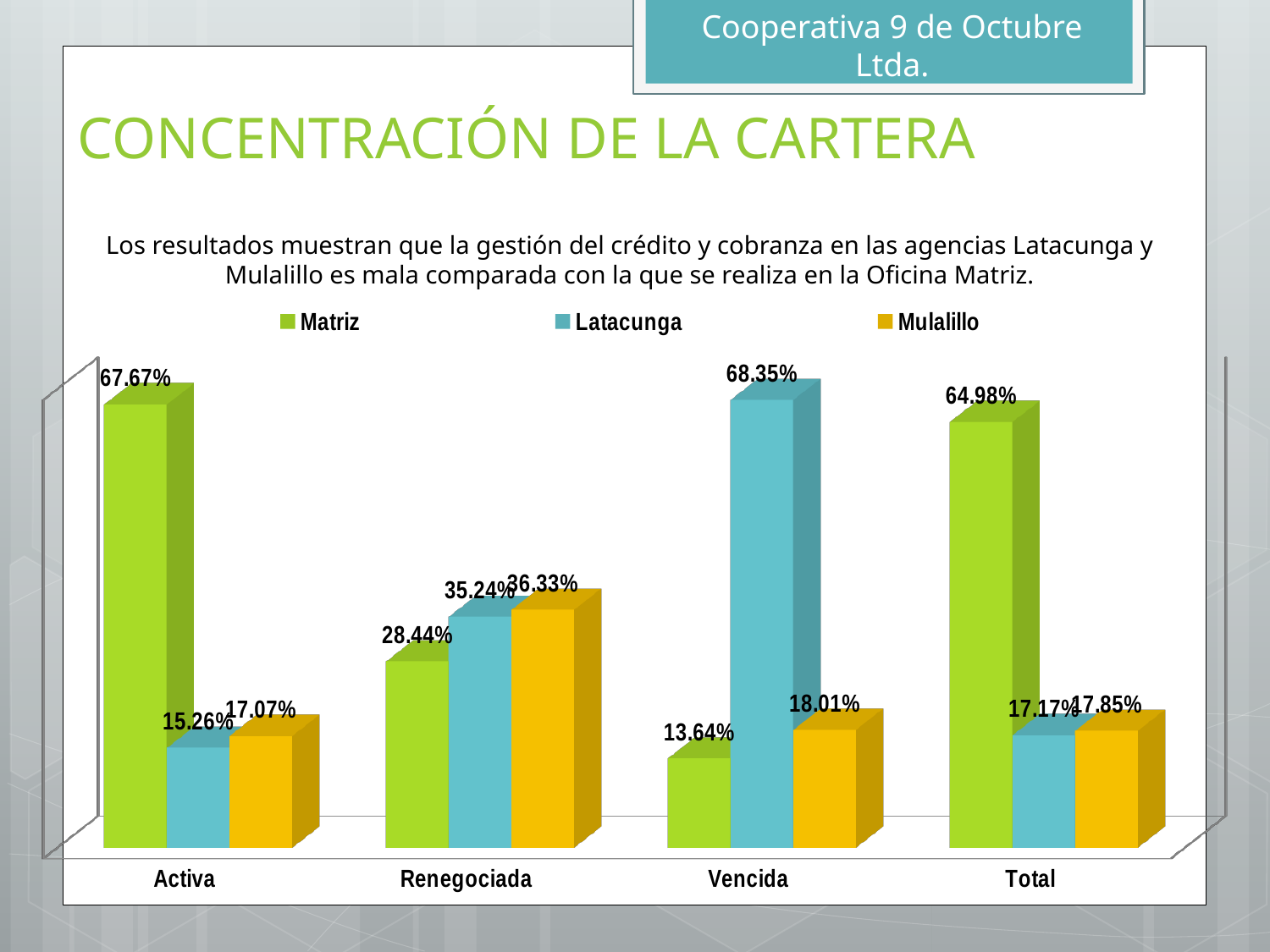
Which is larger in the Renegociada category, the Matriz value or the Latacunga value? Latacunga How many categories are shown on the x axis? 4 What kind of chart is shown on the slide? Bar chart How many series does the legend list? 3 What is the value for Matriz in the Activa category? 67.67% What is the value for Matriz in the Total category? 64.98% Which series has the lowest value in the Activa category? Latacunga What is the value for Mulalillo in the Renegociada category? 36.33% What is the difference between the Matriz and Latacunga values in the Activa category? 52.41% Which series has the highest value in the Vencida category? Latacunga What is the value for Latacunga in the Vencida category? 68.35% Which series is shown in green in the legend? Matriz